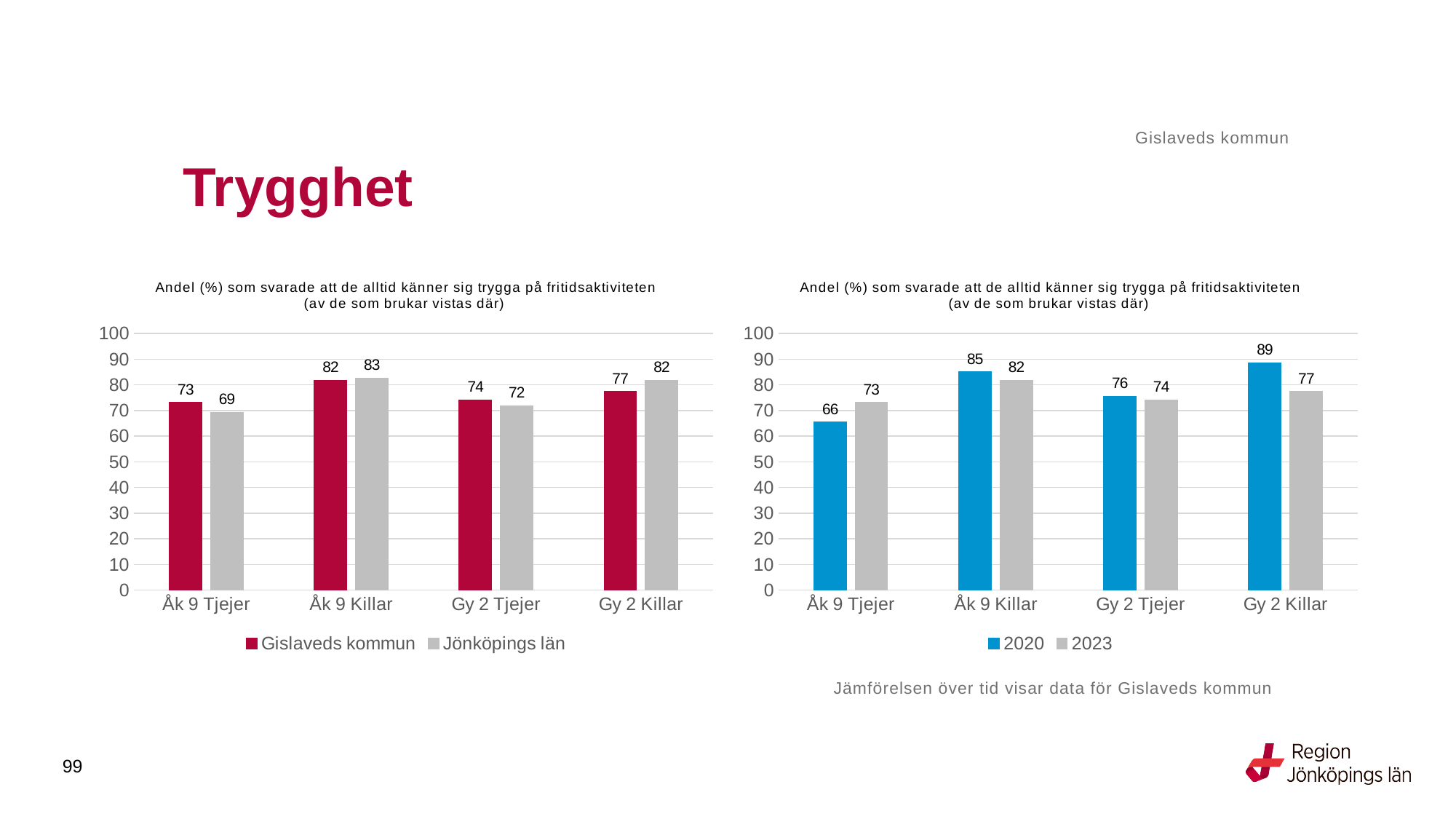
In the left chart, what is the value for Gislaveds kommun for Åk 9 Killar? 82 How many series does the legend of the right chart list? 2 In the left chart, which category has the lowest value for Jönköpings län? Åk 9 Tjejer In the right chart, what is the value for 2023 for Åk 9 Tjejer? 73 In the right chart, what is the difference between the 2020 and 2023 values for Gy 2 Killar? 12 How many categories are shown on the x axis of the left chart? 4 In the right chart, which category has the highest value for 2020? Gy 2 Killar In the left chart, what is the difference between Gislaveds kommun and Jönköpings län for Gy 2 Killar? 5 What kind of chart is the left chart? Bar chart In the right chart, what is the value for 2020 for Gy 2 Killar? 89 In the right chart, which is larger for Åk 9 Tjejer: the 2020 value or the 2023 value? 2023 In the left chart, what is the value for Jönköpings län for Gy 2 Tjejer? 72